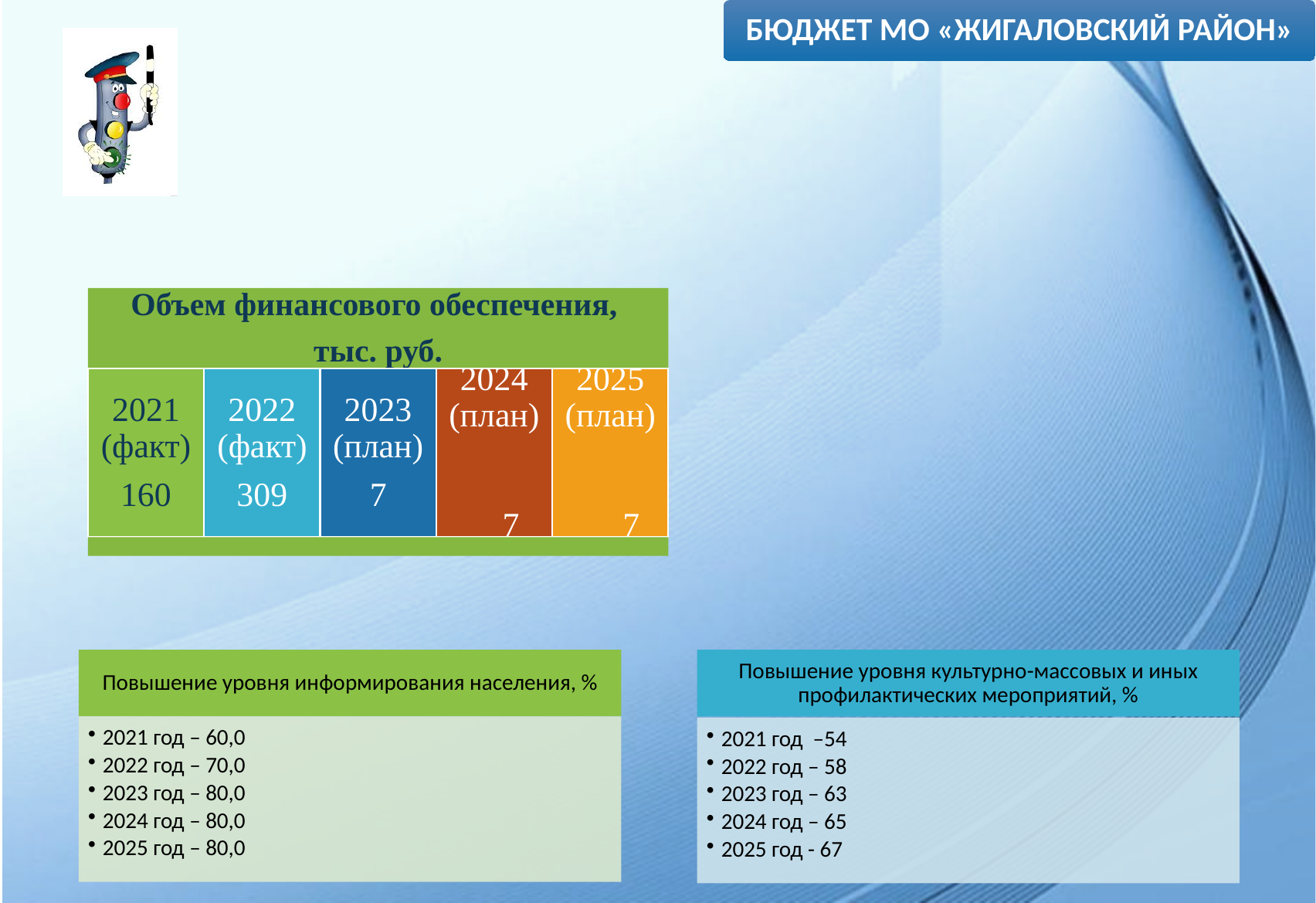
In the "Объем финансового обеспечения, тыс. руб." graphic, what is the value for 2021 (факт)? 160 In the "Объем финансового обеспечения, тыс. руб." graphic, which year has the highest value? 2022 (факт) In the "Объем финансового обеспечения, тыс. руб." graphic, what is the value for 2022 (факт)? 309 What unit is given in the title of the "Объем финансового обеспечения" graphic? тыс. руб. How many years are shown in the "Объем финансового обеспечения, тыс. руб." graphic? 5 In the "Объем финансового обеспечения, тыс. руб." graphic, do the values rise or fall from 2022 to 2023? fall In the "Объем финансового обеспечения, тыс. руб." graphic, what is the value for 2023 (план)? 7 In the "Объем финансового обеспечения, тыс. руб." graphic, how many years are marked as (план)? 3 In the "Объем финансового обеспечения, тыс. руб." graphic, what is the difference between the 2022 (факт) and 2021 (факт) values? 149 In the "Объем финансового обеспечения, тыс. руб." graphic, what is the value for 2025 (план)? 7 In the "Объем финансового обеспечения, тыс. руб." graphic, what is the difference between the 2021 (факт) and 2023 (план) values? 153 In the "Объем финансового обеспечения, тыс. руб." graphic, which is larger, the value for 2021 (факт) or 2022 (факт)? 2022 (факт)